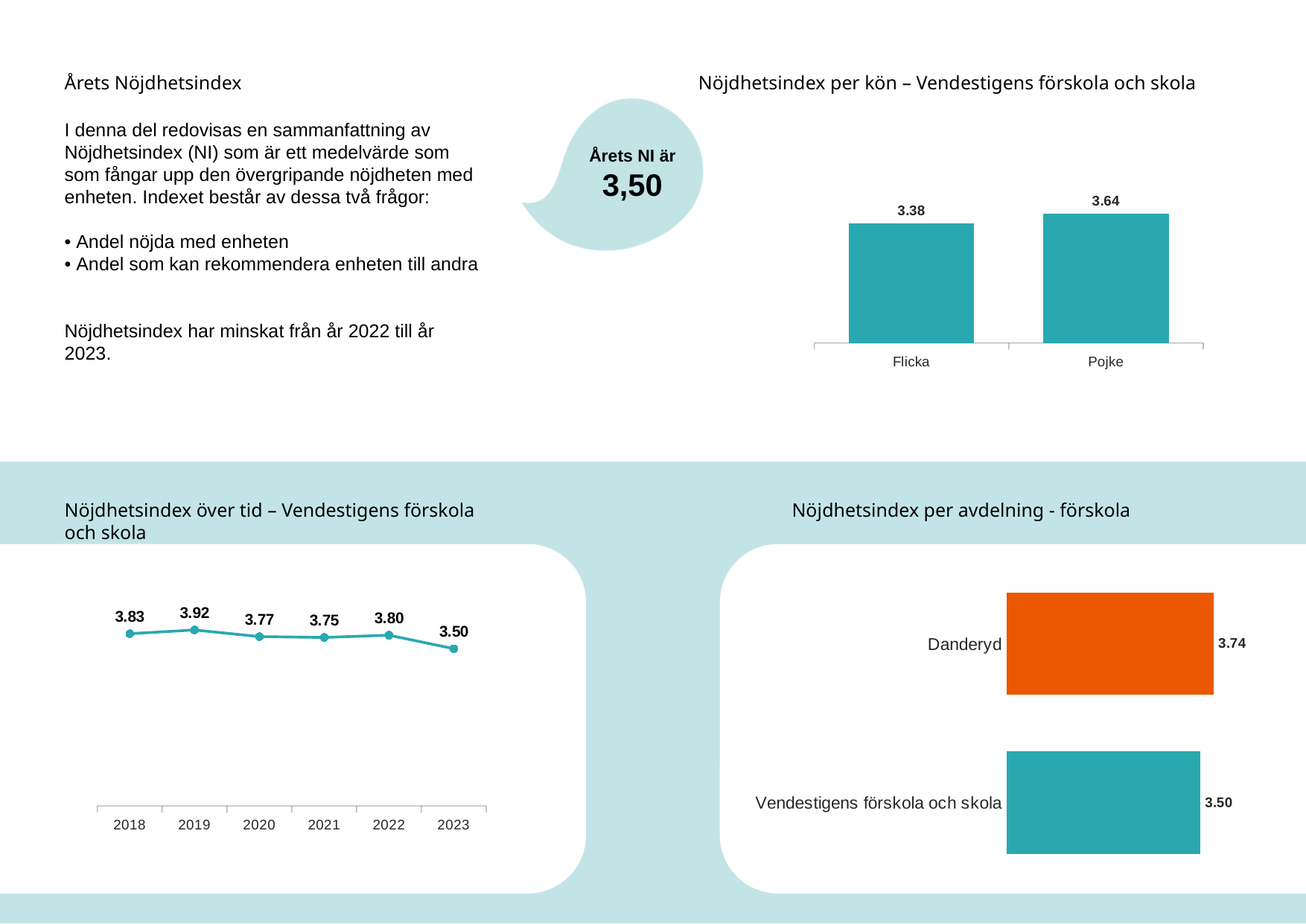
In the 'Nöjdhetsindex per kön' chart, which category has the higher value? Pojke In the 'Nöjdhetsindex över tid' chart, what is the value for 2019? 3.92 In the 'Nöjdhetsindex över tid' chart, what is the difference between 2022 and 2023? 0.30 In the 'Nöjdhetsindex över tid' chart, how many years are plotted? 6 In the 'Nöjdhetsindex per avdelning - förskola' chart, which is larger: Danderyd or Vendestigens förskola och skola? Danderyd In the 'Nöjdhetsindex per kön' chart, what is the difference between Pojke and Flicka? 0.26 In the 'Nöjdhetsindex över tid' chart, which year has the highest value? 2019 What kind of chart is 'Nöjdhetsindex över tid'? Line chart In the 'Nöjdhetsindex per avdelning - förskola' chart, what is the value for Danderyd? 3.74 What kind of chart is 'Nöjdhetsindex per kön'? Bar chart In the 'Nöjdhetsindex över tid' chart, which year has the lowest value? 2023 In the 'Nöjdhetsindex per kön' chart, what is the value for Flicka? 3.38